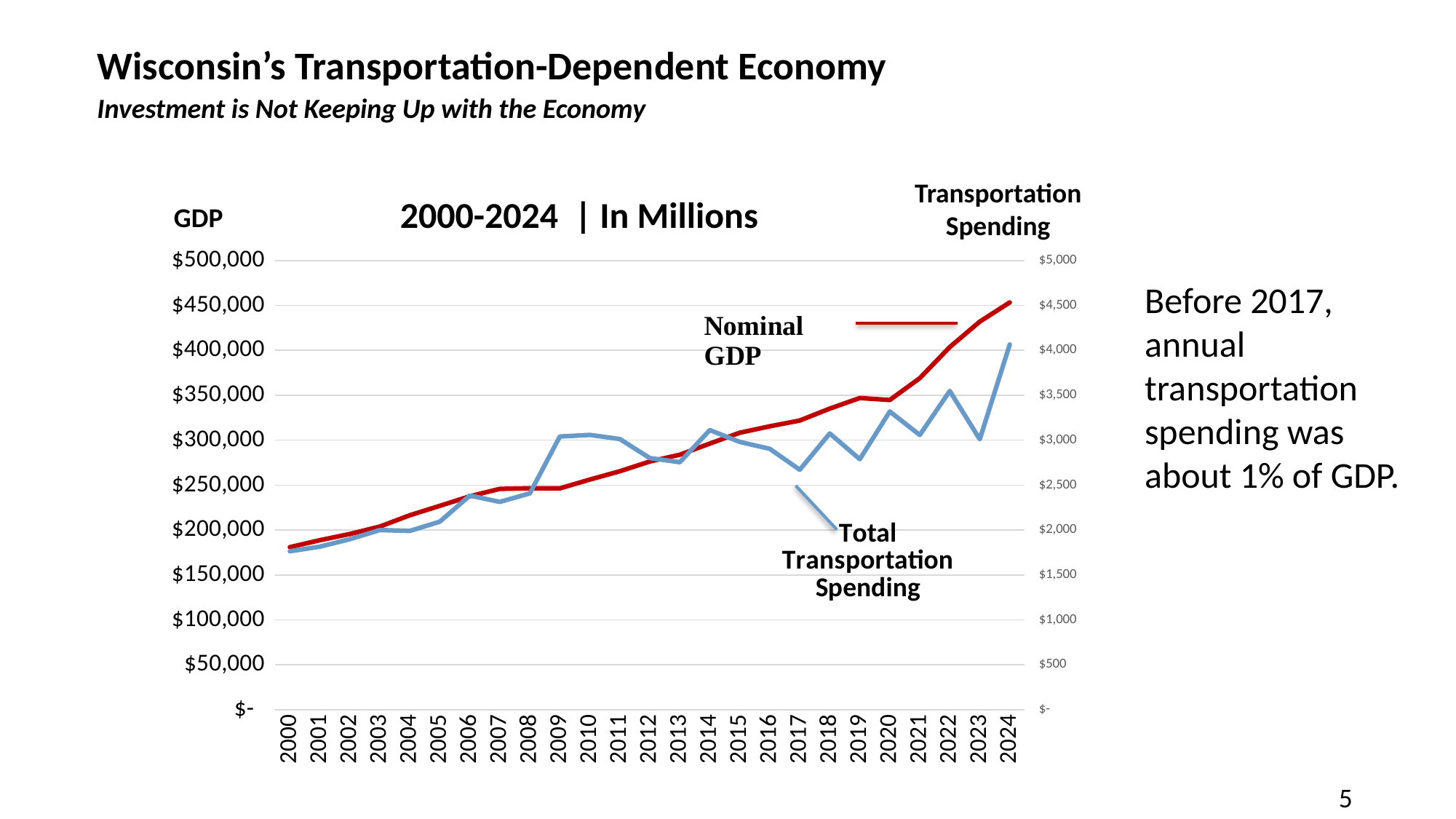
In which year is Nominal GDP highest? 2024 Does Nominal GDP generally rise or fall from 2000 to 2024? Rise What colour is the Nominal GDP line on the chart? Red Is the Nominal GDP value for 2000 greater or less than $200,000? less Is the Nominal GDP value for 2024 greater or less than $400,000? greater Is the Total Transportation Spending value for 2017 greater or less than $3,000? less In which year is Total Transportation Spending highest? 2024 What kind of chart is shown on the slide? Line chart How many years are shown along the x axis of the chart? 25 How many series are plotted on the chart? 2 In which year is Total Transportation Spending lowest? 2000